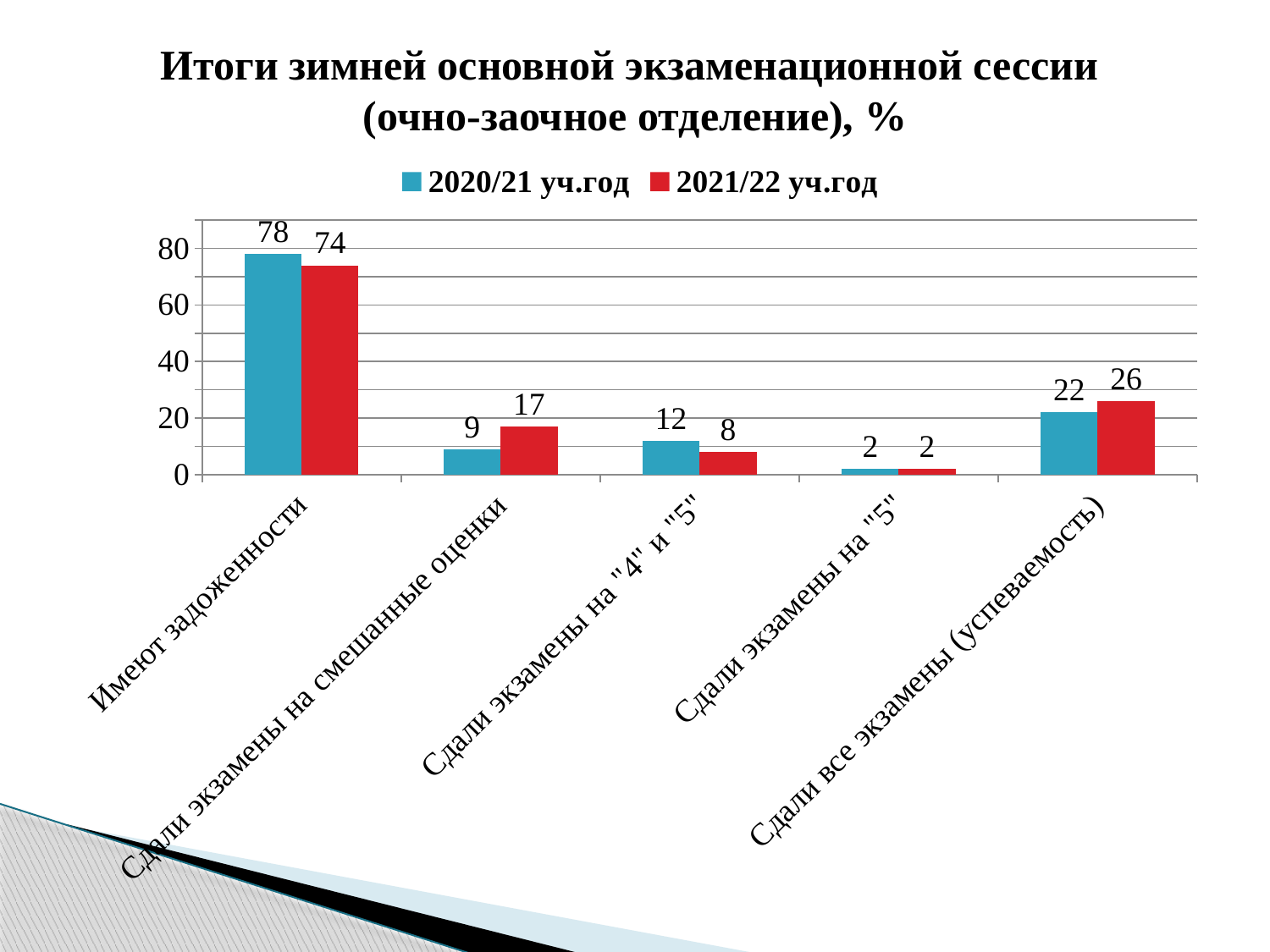
Which category has the lowest value for 2021/22 уч.год? Сдали экзамены на "5" Which series has the larger value for "Сдали экзамены на "4" и "5"": 2020/21 уч.год or 2021/22 уч.год? 2020/21 уч.год What is the value for 2021/22 уч.год in the category "Сдали экзамены на смешанные оценки"? 17 What is the value for 2021/22 уч.год in the category "Сдали все экзамены (успеваемость)"? 26 Which category has the highest value for 2020/21 уч.год? Имеют задоженности What is the difference between the 2020/21 уч.год and 2021/22 уч.год values for "Имеют задоженности"? 4 What is the difference between the 2021/22 уч.год and 2020/21 уч.год values for "Сдали экзамены на смешанные оценки"? 8 How many categories are shown on the x axis? 5 What kind of chart is shown on the slide? Bar chart What is the value for 2020/21 уч.год in the category "Имеют задоженности"? 78 How many series does the legend list? 2 Which colour represents the 2021/22 уч.год series? Red